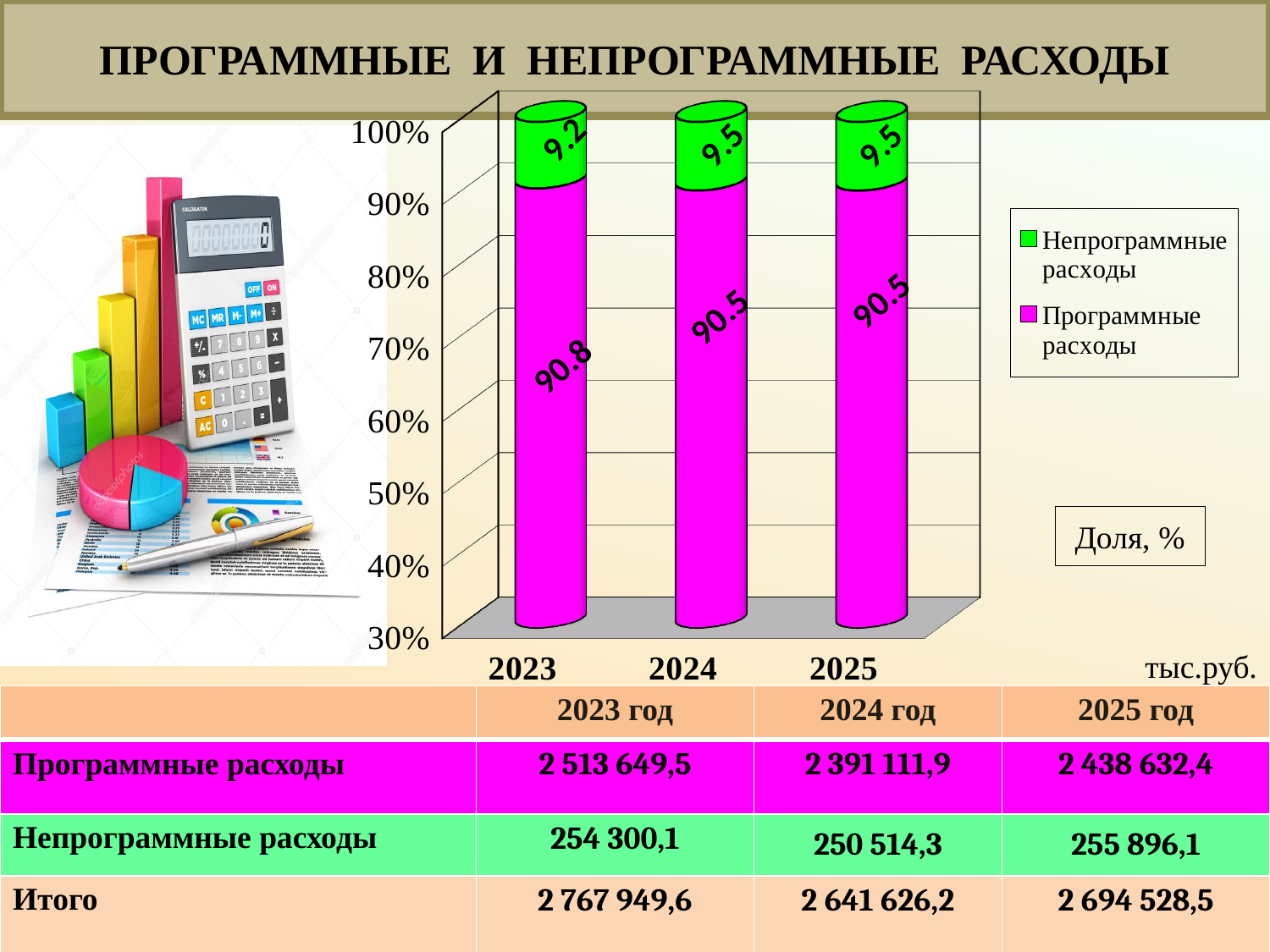
What is the value for Программные расходы in 2025? 90.5 How many series does the chart legend list? 2 What kind of chart is shown on the slide? Stacked bar chart Which is larger: Непрограммные расходы in 2023 or in 2025? 2025 What is the value for Программные расходы in 2023? 90.8 How many years are shown on the x axis of the chart? 3 Does the share of Непрограммные расходы rise or fall from 2023 to 2024? Rise In which year is the share of Непрограммные расходы lowest? 2023 What is the value for Непрограммные расходы in 2024? 9.5 What is the difference between the Программные расходы values for 2023 and 2024? 0.3 In which year is the share of Программные расходы highest? 2023 What is the value for Непрограммные расходы in 2023? 9.2